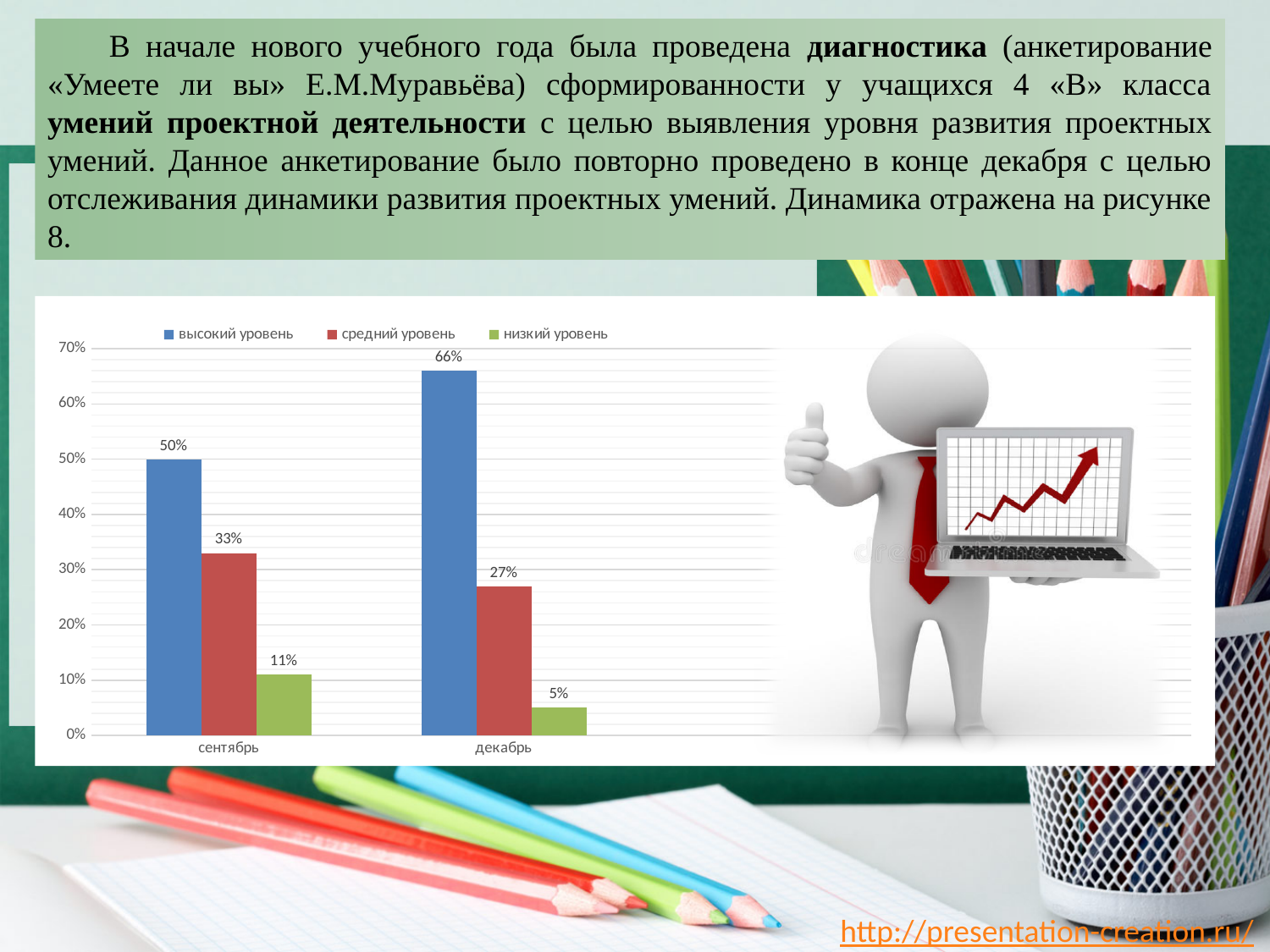
Which colour represents низкий уровень in the chart? green What is the value for низкий уровень in декабрь? 5% Which is larger: средний уровень in сентябрь or средний уровень in декабрь? средний уровень in сентябрь Which series has the highest value in декабрь? высокий уровень Which series has the lowest value in сентябрь? низкий уровень What is the value for высокий уровень in сентябрь? 50% What kind of chart is shown on the slide? bar chart By how many percentage points did высокий уровень change from сентябрь to декабрь? 16% How many series does the legend list? 3 What is the difference between средний уровень and низкий уровень in сентябрь? 22% What is the value for средний уровень in декабрь? 27% How many categories are shown on the x axis? 2